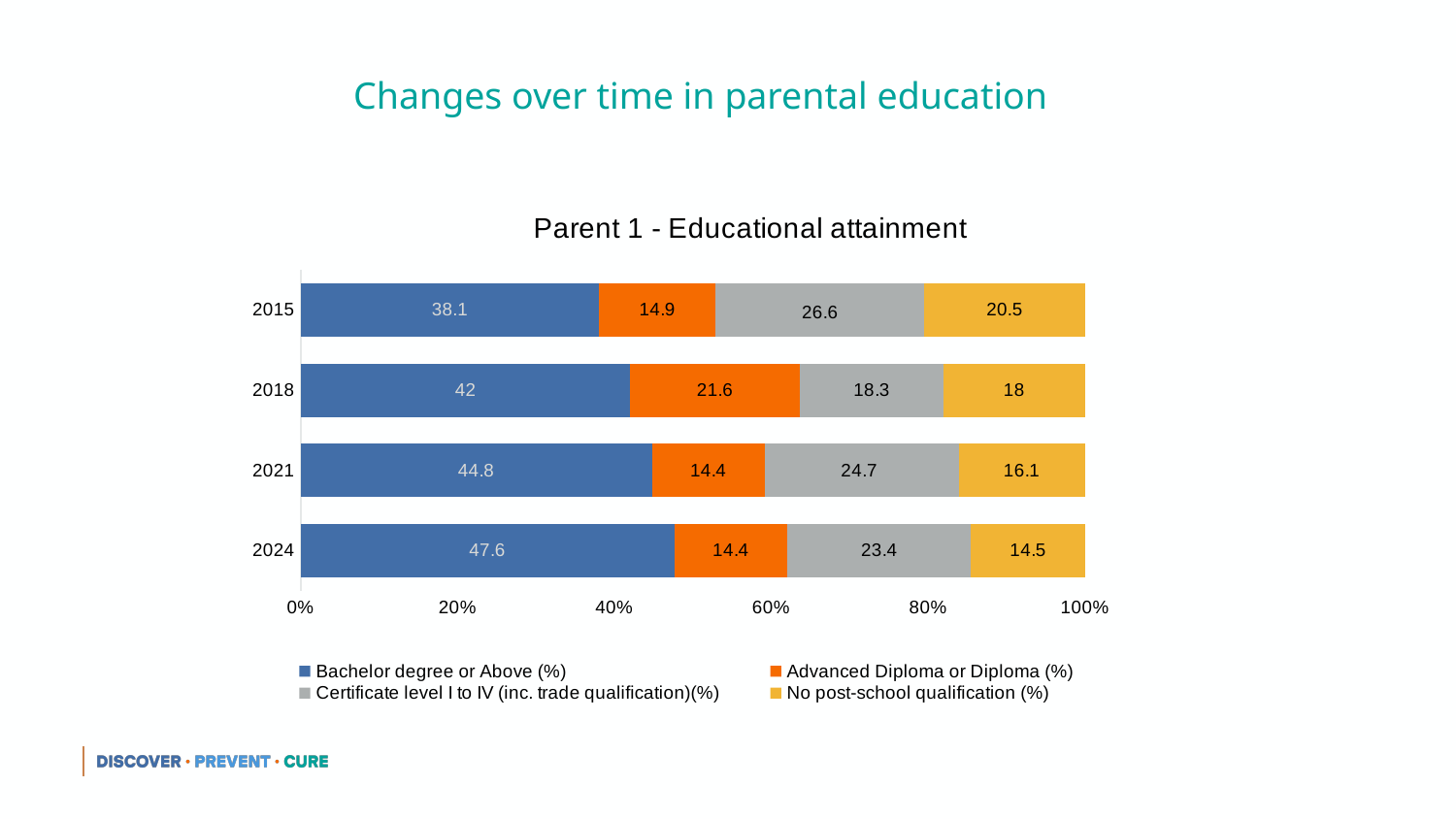
What kind of chart is shown on the slide? Stacked bar chart What is the value for No post-school qualification (%) in 2015? 20.5 What is the value for Bachelor degree or Above (%) in 2024? 47.6 How many years are shown on the chart? 4 Which year has the highest value for Bachelor degree or Above (%)? 2024 What is the difference between the Bachelor degree or Above (%) values for 2024 and 2015? 9.5 How many series does the legend list? 4 Which year has the lowest value for No post-school qualification (%)? 2024 What is the value for Certificate level I to IV (inc. trade qualification)(%) in 2021? 24.7 What is the value for Advanced Diploma or Diploma (%) in 2018? 21.6 Which is larger: the Certificate level I to IV value for 2015 or for 2018? 2015 Does the value for Bachelor degree or Above (%) rise or fall from 2015 to 2024? Rise